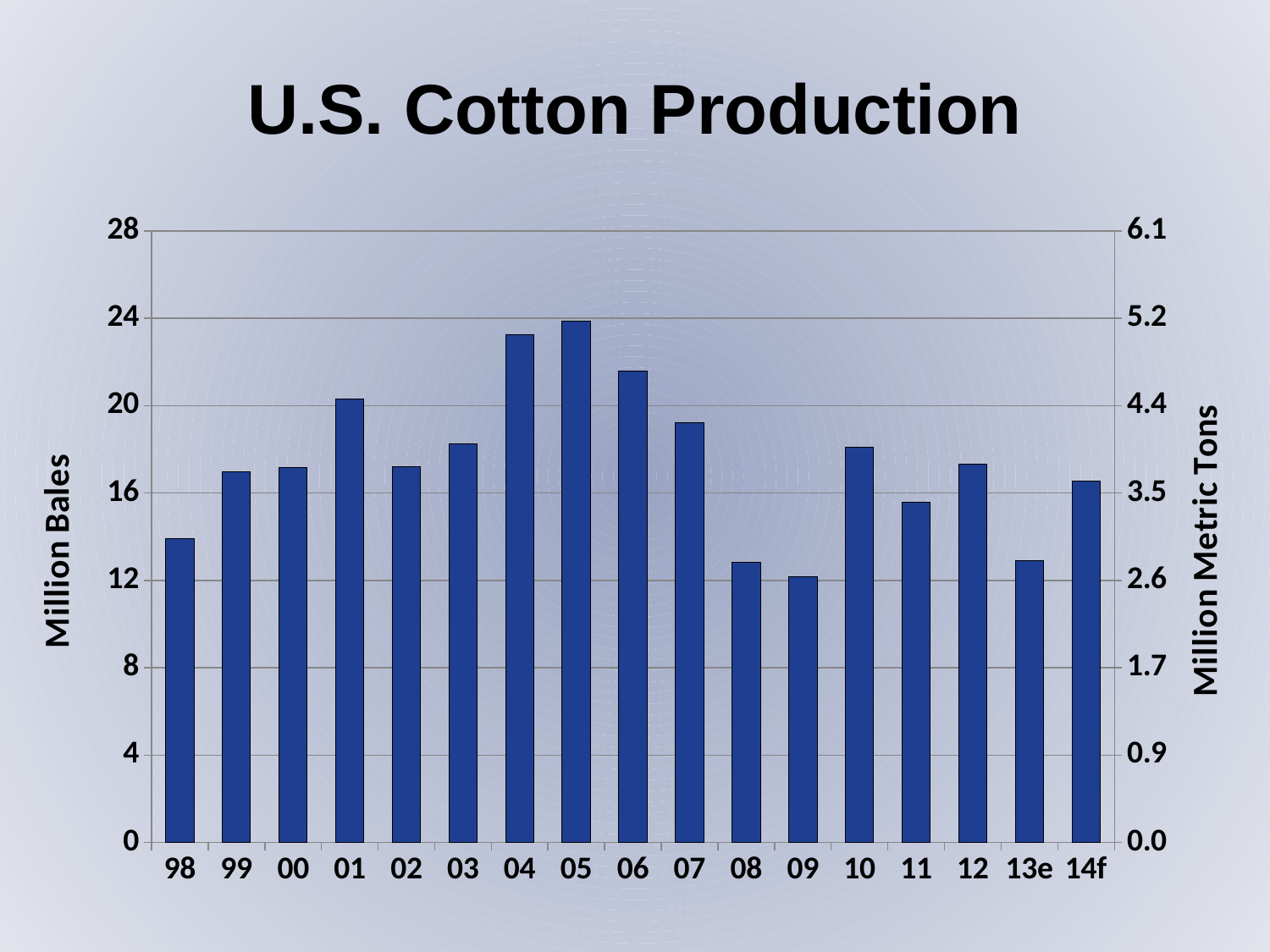
Which year has the lowest cotton production? 09 Is the value for 98 greater or less than 16 million bales? less Is the value for 04 greater or less than 20 million bales? greater What is the title of the chart? U.S. Cotton Production Is the value for 06 greater or less than 20 million bales? greater What kind of chart is shown on the slide? bar chart What is the label on the left vertical axis? Million Bales Do the values rise or fall from 05 to 09? fall How many years (bars) are shown on the x axis? 17 Which year has the highest cotton production? 05 Which year has the larger production, 04 or 06? 04